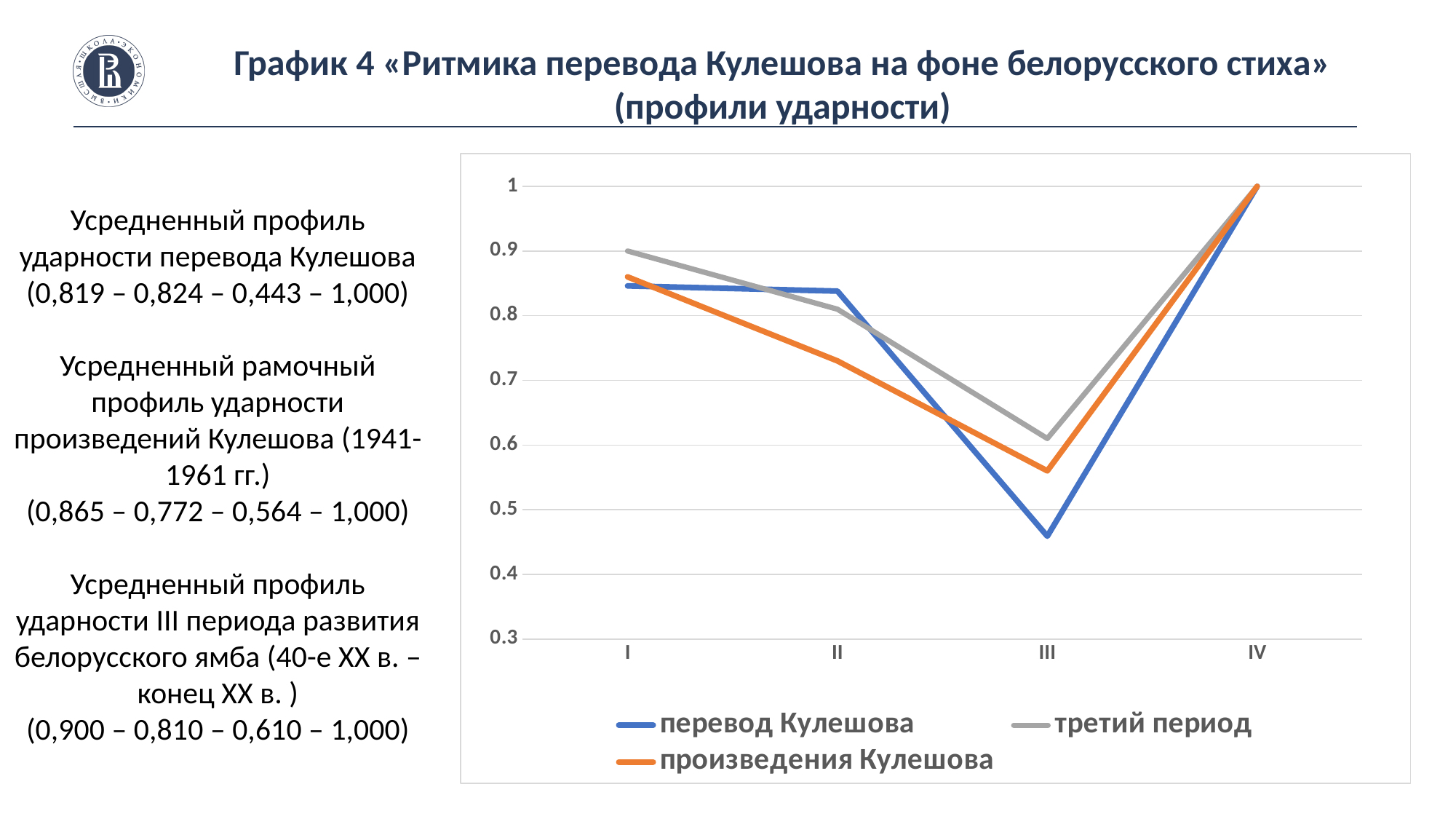
Is the value for третий период at category I greater or less than 0.8? greater What is the value of перевод Кулешова at category IV? 1 How many series does the legend list? 3 Is the value for перевод Кулешова at category III greater or less than 0.5? less What kind of chart is shown on the slide? line chart How many categories are on the x axis? 4 Is the value for произведения Кулешова at category III greater or less than 0.6? less Does the перевод Кулешова line rise or fall from category II to category III? fall At which category does перевод Кулешова reach its lowest value? III At which category do all three series reach their highest value? IV What colour is the line for произведения Кулешова? orange At category III, which is larger: третий период or перевод Кулешова? третий период